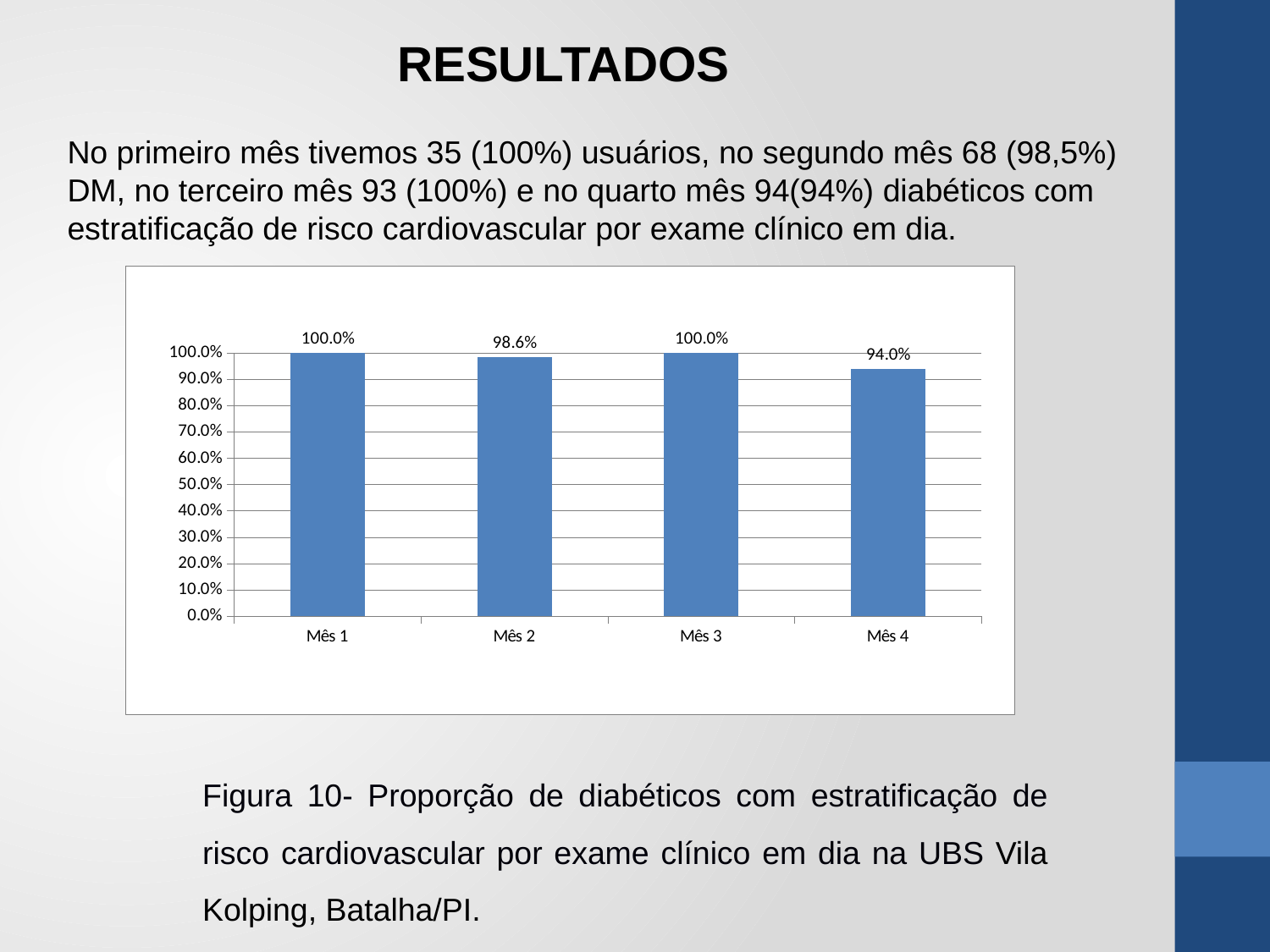
What is the value for Mês 1? 100.0% Which is larger, the value for Mês 2 or the value for Mês 4? Mês 2 How many months are shown on the x axis? 4 Is the value for Mês 4 greater or less than 90.0%? greater Which month has the lowest value? Mês 4 Which months share the highest value of 100.0%? Mês 1 and Mês 3 What is the value for Mês 2? 98.6% What is the difference between the values for Mês 2 and Mês 4? 4.6 percentage points Does the value rise or fall from Mês 3 to Mês 4? Fall What is the difference between the values for Mês 1 and Mês 4? 6.0 percentage points What is the value for Mês 4? 94.0% What kind of chart is shown on the slide? Bar chart